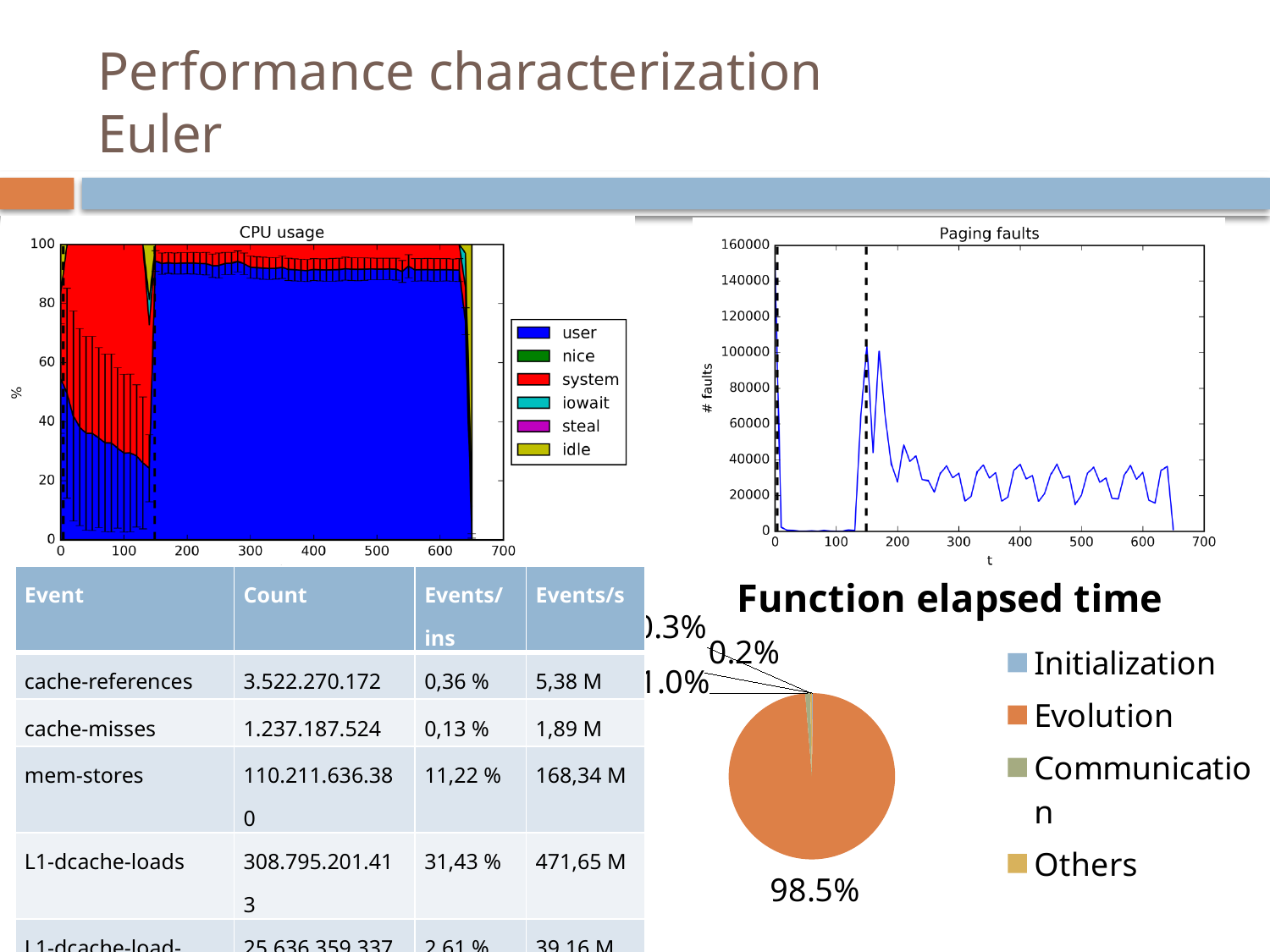
In the CPU usage chart, which colour represents the system series? Red In the Paging faults chart, is the peak number of faults greater or less than 80000? greater How many entries does the legend of the Function elapsed time pie chart list? 4 In the CPU usage chart, is the user share at t = 400 greater or less than 80? greater In the Paging faults chart, is the number of faults at t = 100 greater or less than 20000? less What kind of chart is the Function elapsed time chart? Pie chart In the Function elapsed time pie chart, which function accounts for the largest share of elapsed time? Evolution How many series does the legend of the CPU usage chart list? 6 What kind of chart is the Paging faults chart? Line chart In the Function elapsed time pie chart, what share of the elapsed time is taken by Evolution? 98.5% In the Function elapsed time pie chart, which colour represents Evolution? Orange